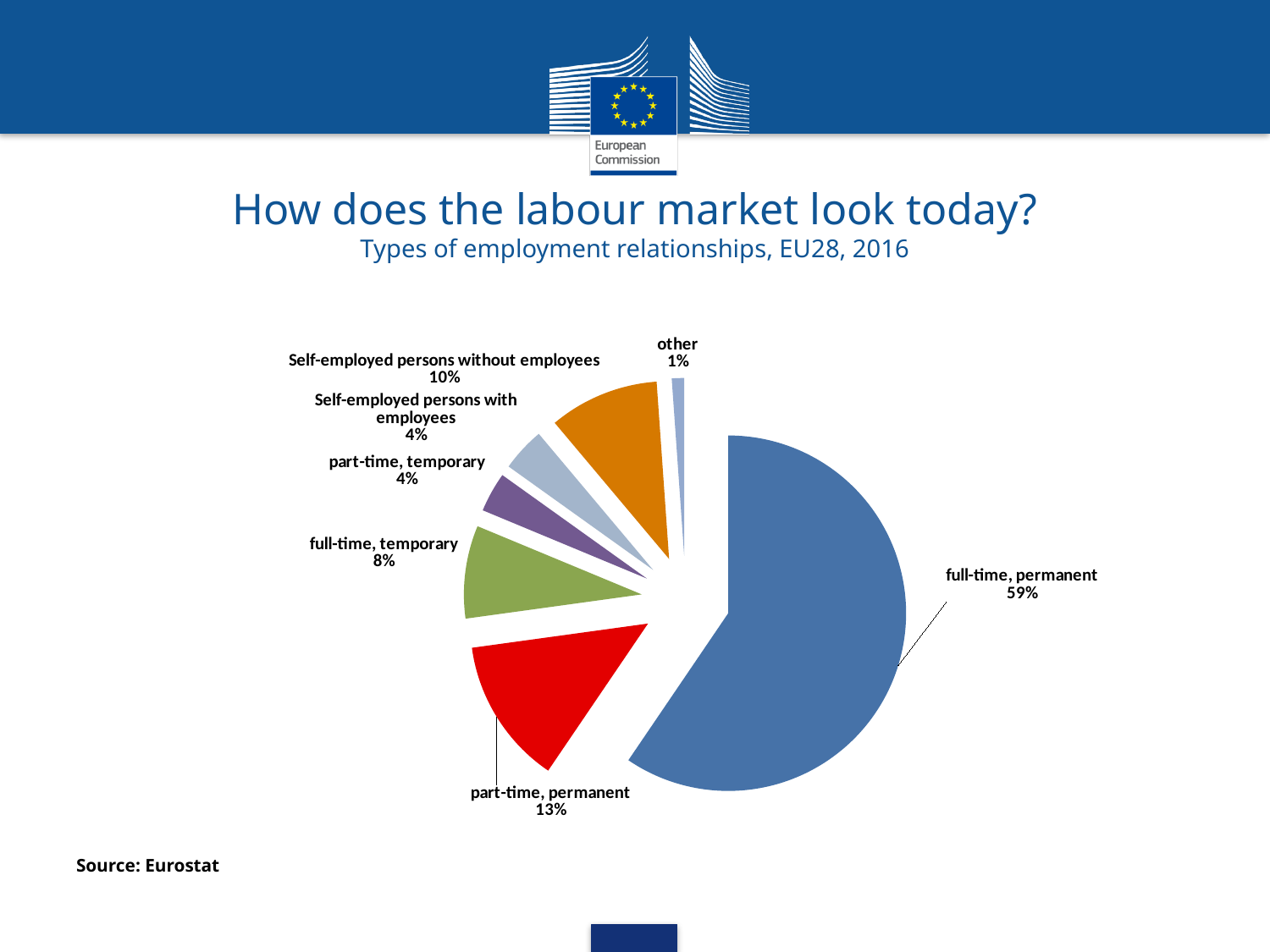
Which category has the largest share of the pie? full-time, permanent What share is shown for the 'other' category? 1% Which is larger: the share for full-time, temporary or the share for self-employed persons without employees? Self-employed persons without employees What share of employment relationships is full-time, temporary? 8% How many categories are shown in the pie chart? 7 What kind of chart is shown on the slide? pie chart What share of employment relationships is full-time, permanent? 59% Which category has the smallest share of the pie? other What is the difference in percentage points between full-time, permanent and part-time, permanent? 46 What is the source cited for the chart? Eurostat What share is shown for self-employed persons without employees? 10% What share of employment relationships is part-time, permanent? 13%